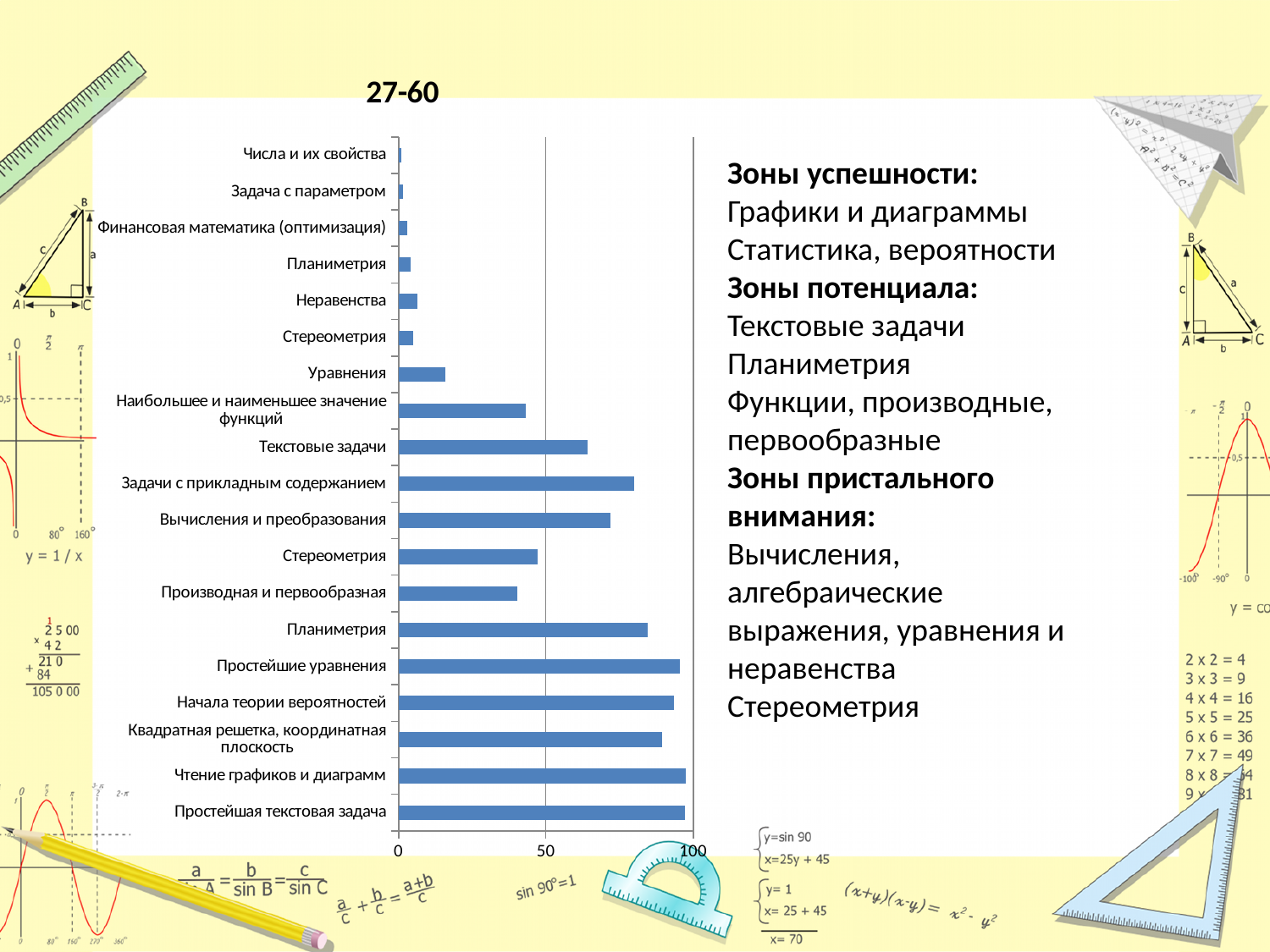
Is the value for Текстовые задачи greater or less than 50? greater What is the title of the chart? 27-60 Which category has the lowest value in the chart? Числа и их свойства Is the value for Уравнения greater or less than 50? less How many categories are plotted in the chart? 19 Which is larger, the value for Задачи с прикладным содержанием or the value for Вычисления и преобразования? Задачи с прикладным содержанием Which is larger, the value for Задача с параметром or the value for Неравенства? Неравенства Is the value for Производная и первообразная greater or less than 50? less Which is larger, the value for Простейшие уравнения or the value for Производная и первообразная? Простейшие уравнения What kind of chart is shown on the slide? bar chart